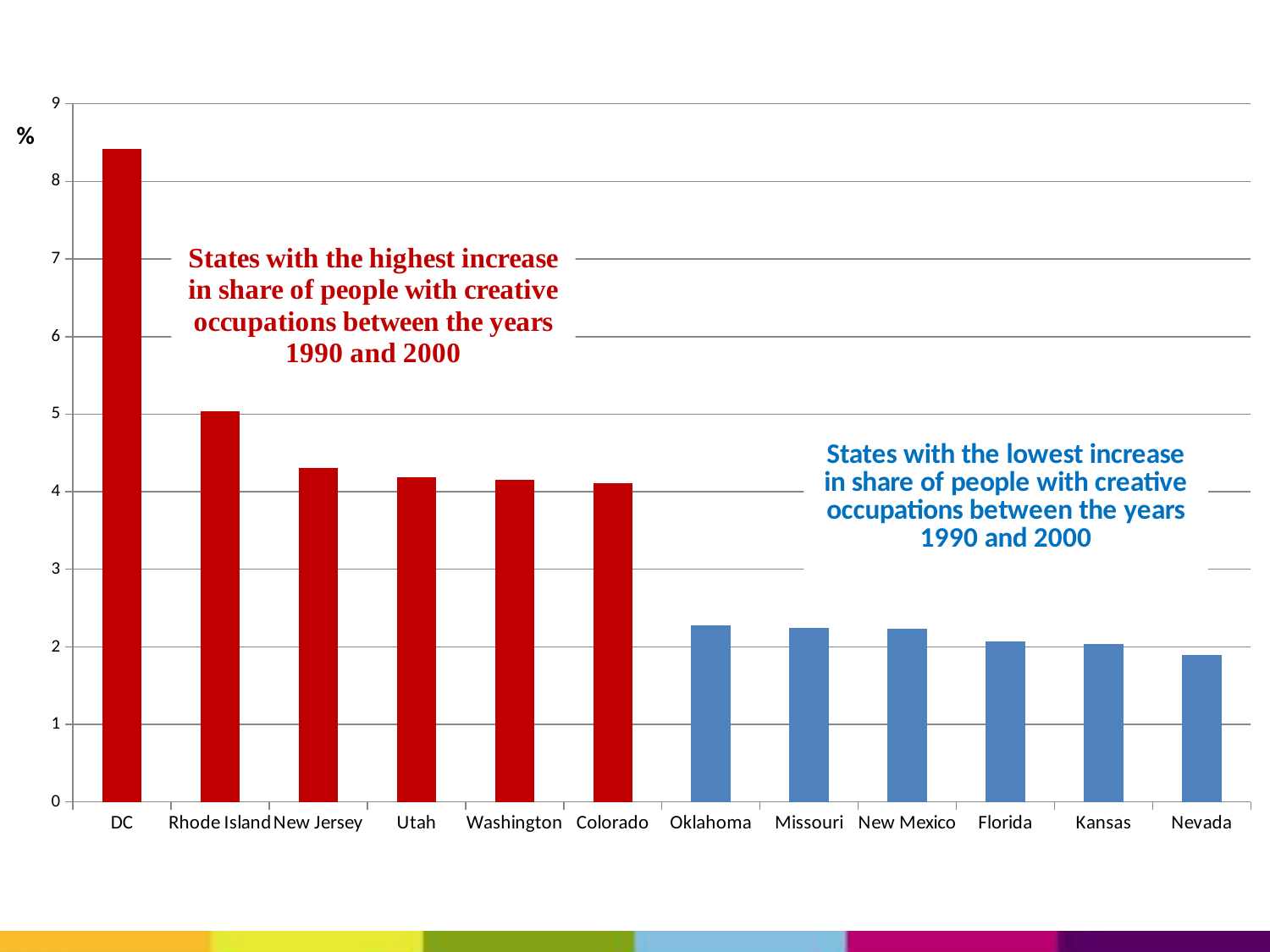
Which state has the highest bar on the chart? DC Which is larger, the value for Utah or the value for Florida? Utah How many states are shown on the x axis of the chart? 12 Is the value for Nevada greater or less than 2? less What kind of chart is shown on the slide? bar chart Do the bar values rise or fall moving from left to right along the x axis? fall Is the value for DC greater or less than 8? greater Which state has the lowest bar on the chart? Nevada How many bars on the chart are coloured red? 6 Is the value for Colorado greater or less than 4? greater